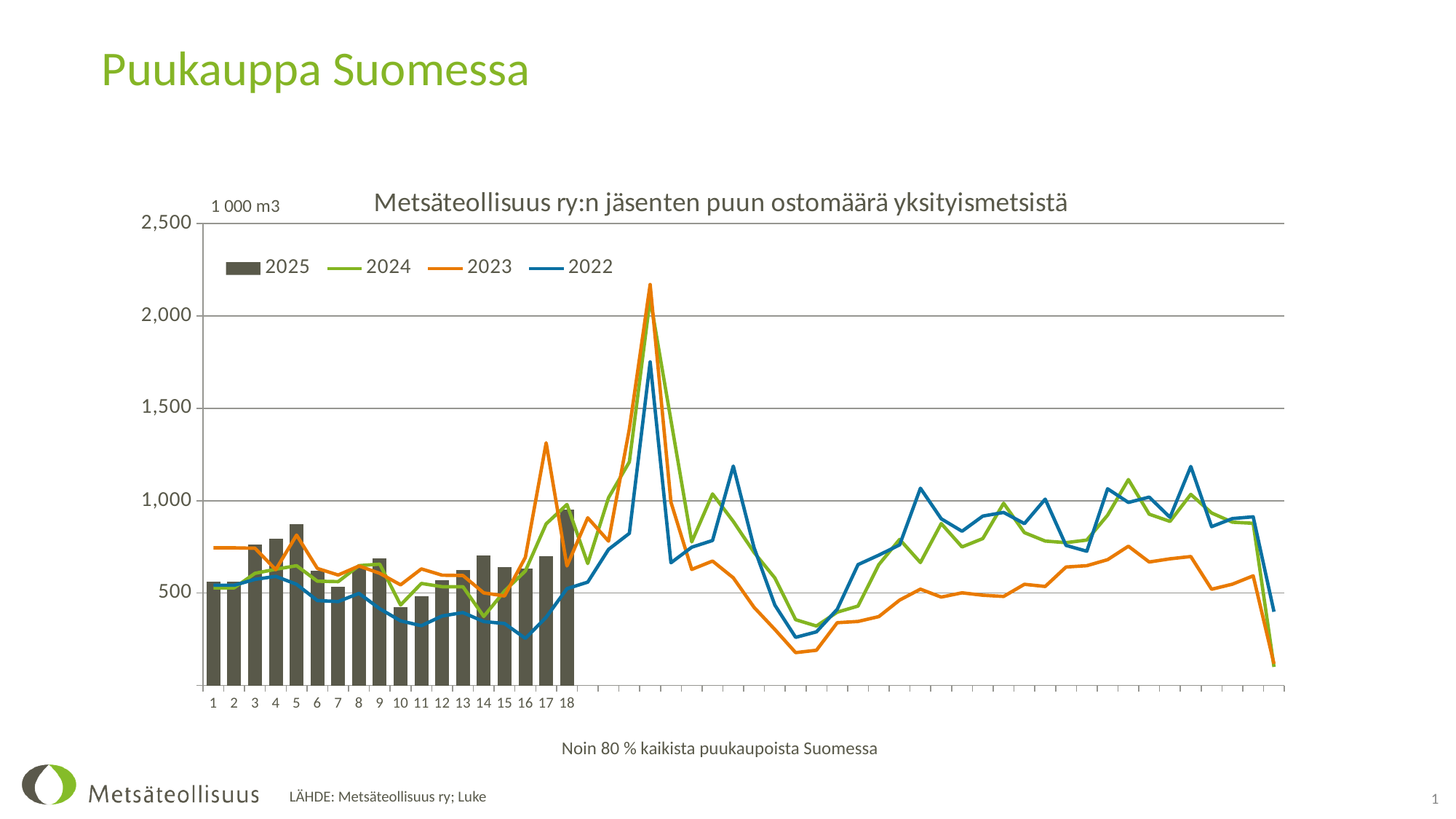
Is the peak of the 2022 line greater or less than 2,000? less At week 16, which is larger: the 2022 line value or the 2025 bar? 2025 Which week has the highest 2025 bar? 18 At week 17, which is larger: the 2023 line value or the 2025 bar? 2023 Is the 2025 bar for week 10 greater or less than 500? less What kind of chart is shown on the slide? A combined bar and line chart Is the 2025 bar for week 18 greater or less than 500? greater Which series is shown as bars rather than a line? 2025 How many series does the legend list? 4 How many bars are plotted for the 2025 series? 18 What is the title of the chart? Metsäteollisuus ry:n jäsenten puun ostomäärä yksityismetsistä